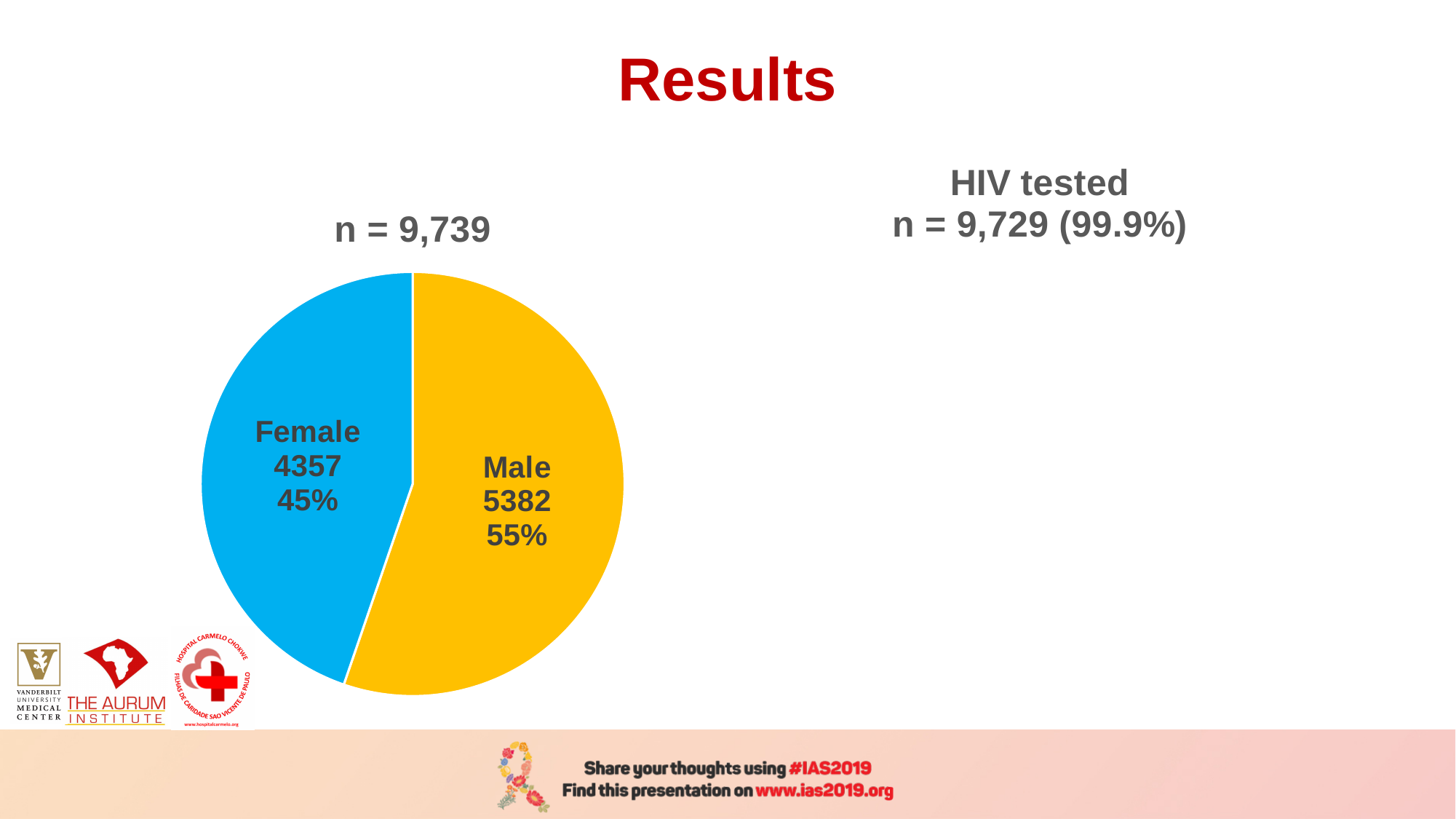
What kind of chart is shown on the slide? pie chart What share of the pie does the Female slice represent? 45% What share of the pie does the Male slice represent? 55% Which slice of the pie chart is the smallest? Female What is the title shown above the pie chart? n = 9,739 What is the difference between the Male and Female counts in the pie chart? 1025 How many slices does the pie chart have? 2 What is the count for Female in the pie chart? 4357 What is the count for Male in the pie chart? 5382 Which slice of the pie chart is the largest? Male What colour is the Female slice of the pie chart? blue Which is larger in the pie chart, Male or Female? Male